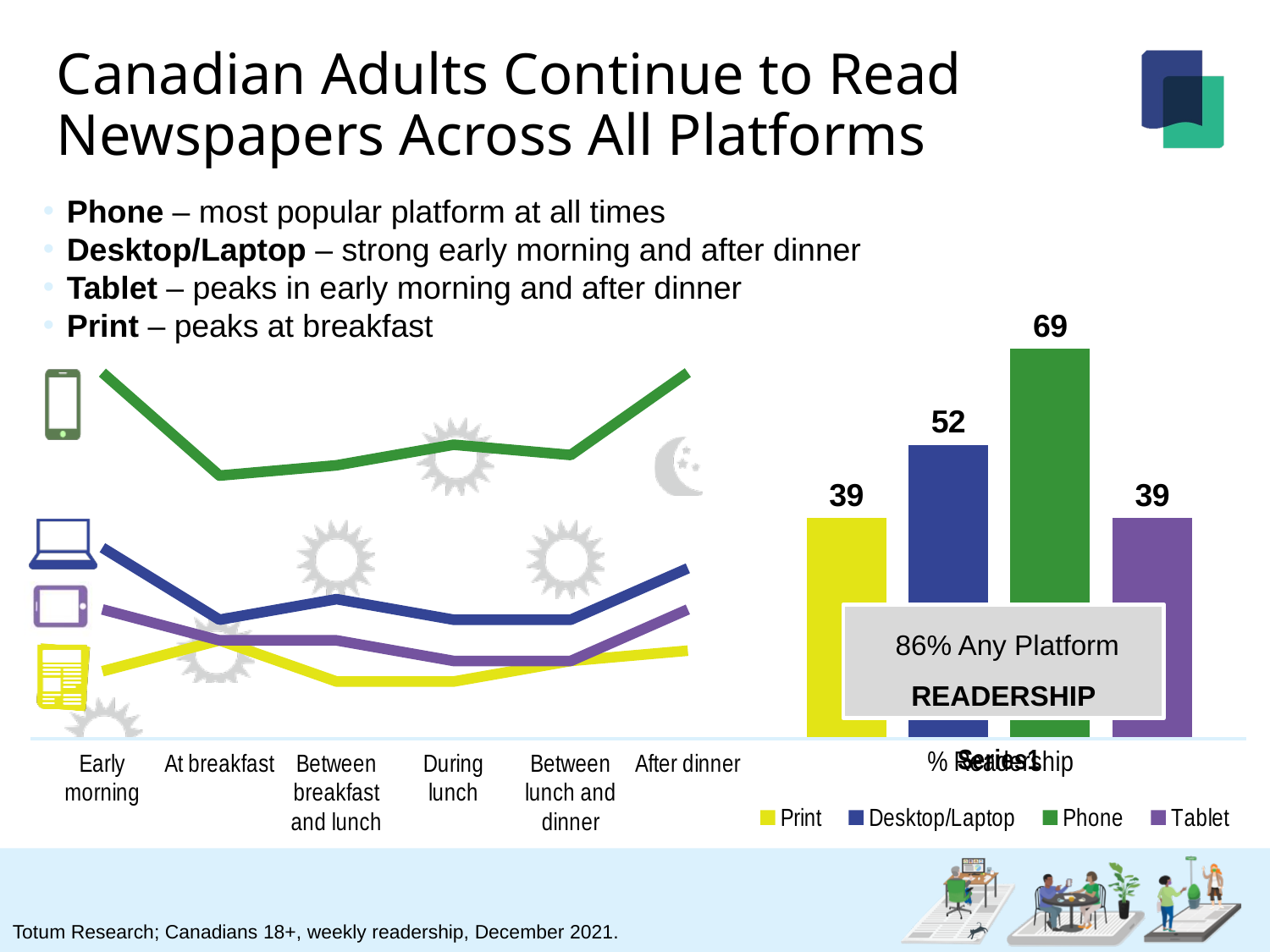
How many time-of-day categories are shown on the x axis of the line chart on the left? 6 In the bar chart on the right, what is the value for Print? 39 In the bar chart on the right, what is the difference between the Desktop/Laptop and Tablet values? 13 What kind of chart is the chart on the left of the slide? Line chart In the line chart on the left, does the Phone line rise or fall from Early morning to At breakfast? Fall In the bar chart on the right, which is larger, the value for Desktop/Laptop or the value for Tablet? Desktop/Laptop How many entries does the legend below the bar chart list? 4 How many bars are shown in the bar chart on the right? 4 In the bar chart on the right, what is the value for Desktop/Laptop? 52 In the bar chart on the right, what is the difference between the Phone and Desktop/Laptop values? 17 In the bar chart on the right, what is the value for Phone? 69 In the bar chart on the right, which platform has the highest value? Phone